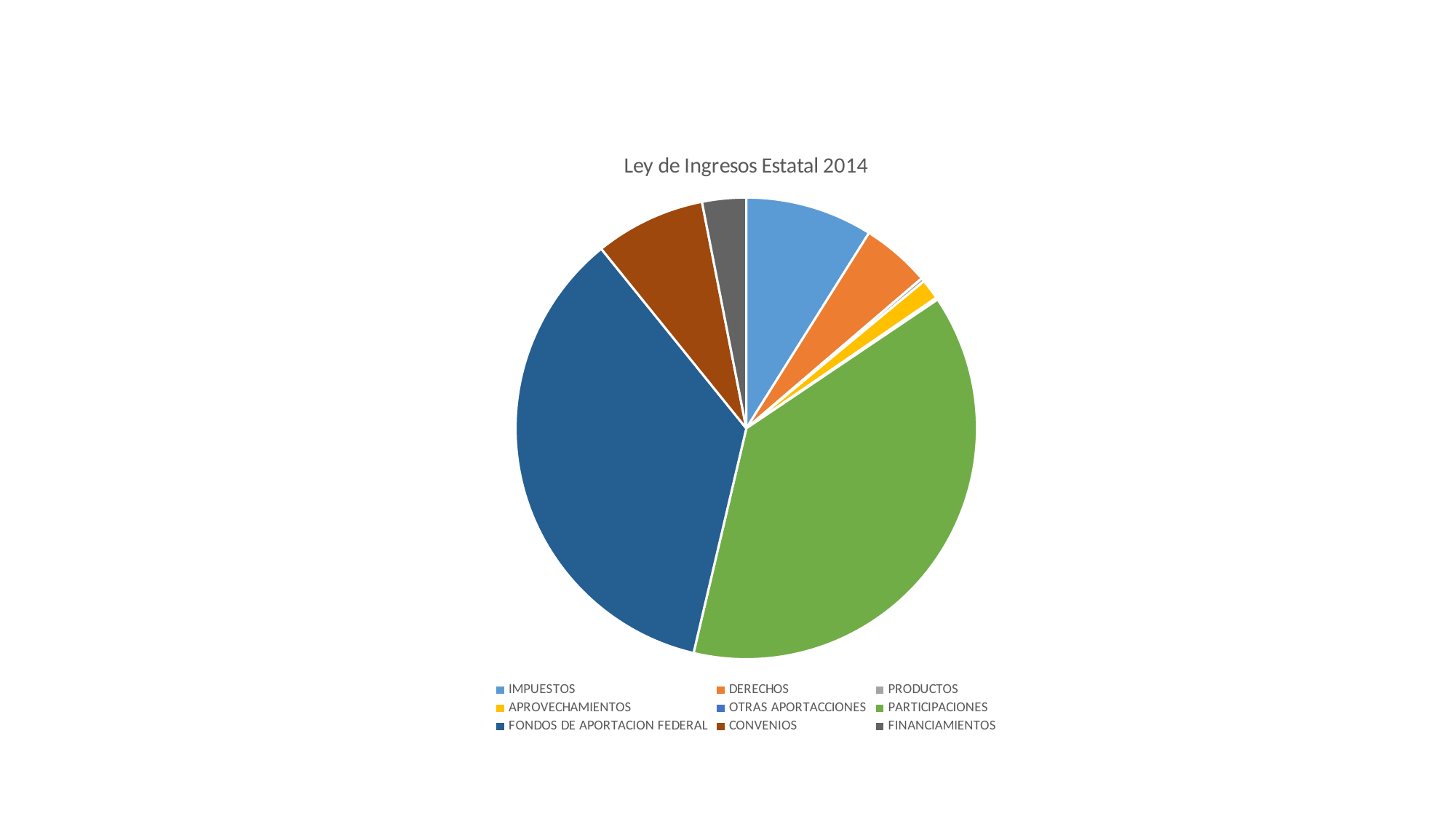
Which slice is larger, FINANCIAMIENTOS or PRODUCTOS? FINANCIAMIENTOS Which slice is larger, IMPUESTOS or DERECHOS? IMPUESTOS What kind of chart is shown on the slide? pie chart How many categories does the legend of the pie chart list? 9 Which slice is larger, FONDOS DE APORTACION FEDERAL or CONVENIOS? FONDOS DE APORTACION FEDERAL Which colour represents PARTICIPACIONES in the pie chart? green What is the title of the chart? Ley de Ingresos Estatal 2014